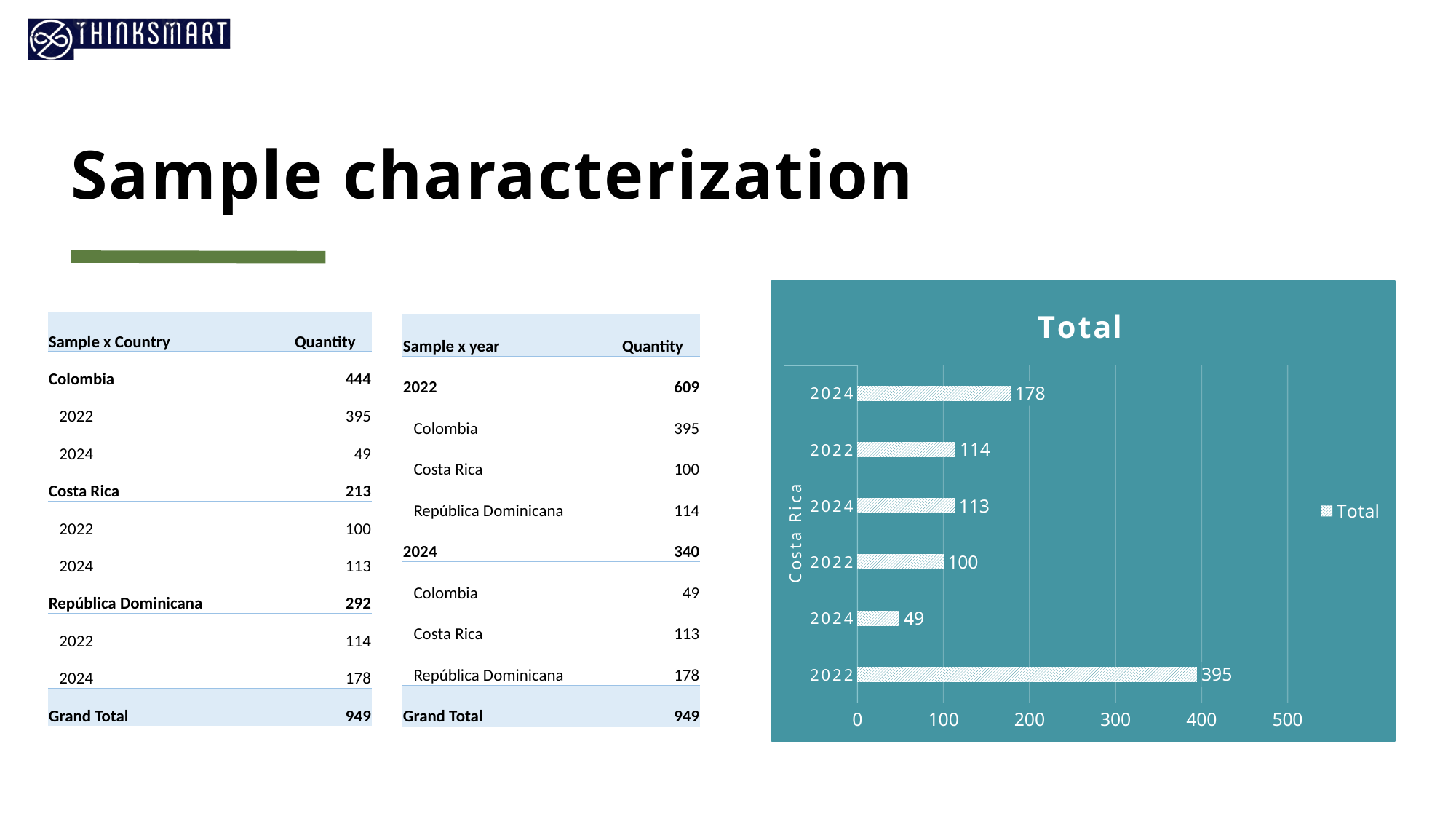
How many bars does the 'Total' chart show? 6 In the 'Total' chart, what is the value of the topmost bar? 178 In the 'Total' chart, what is the value of the 2024 bar in the Costa Rica group? 113 In the 'Total' chart, what is the value of the shortest bar? 49 What kind of chart is shown on the right of the slide? bar chart How many series does the legend of the 'Total' chart list? 1 In the 'Total' chart, what is the difference between the Costa Rica 2024 bar and the Costa Rica 2022 bar? 13 In the 'Total' chart, is the value of the bottom 2022 bar greater or less than 300? greater What is the title of the chart on the right of the slide? Total In the 'Total' chart, what is the value of the 2022 bar in the Costa Rica group? 100 In the 'Total' chart, which Costa Rica bar is larger, 2022 or 2024? 2024 In the 'Total' chart, what is the value of the longest bar? 395